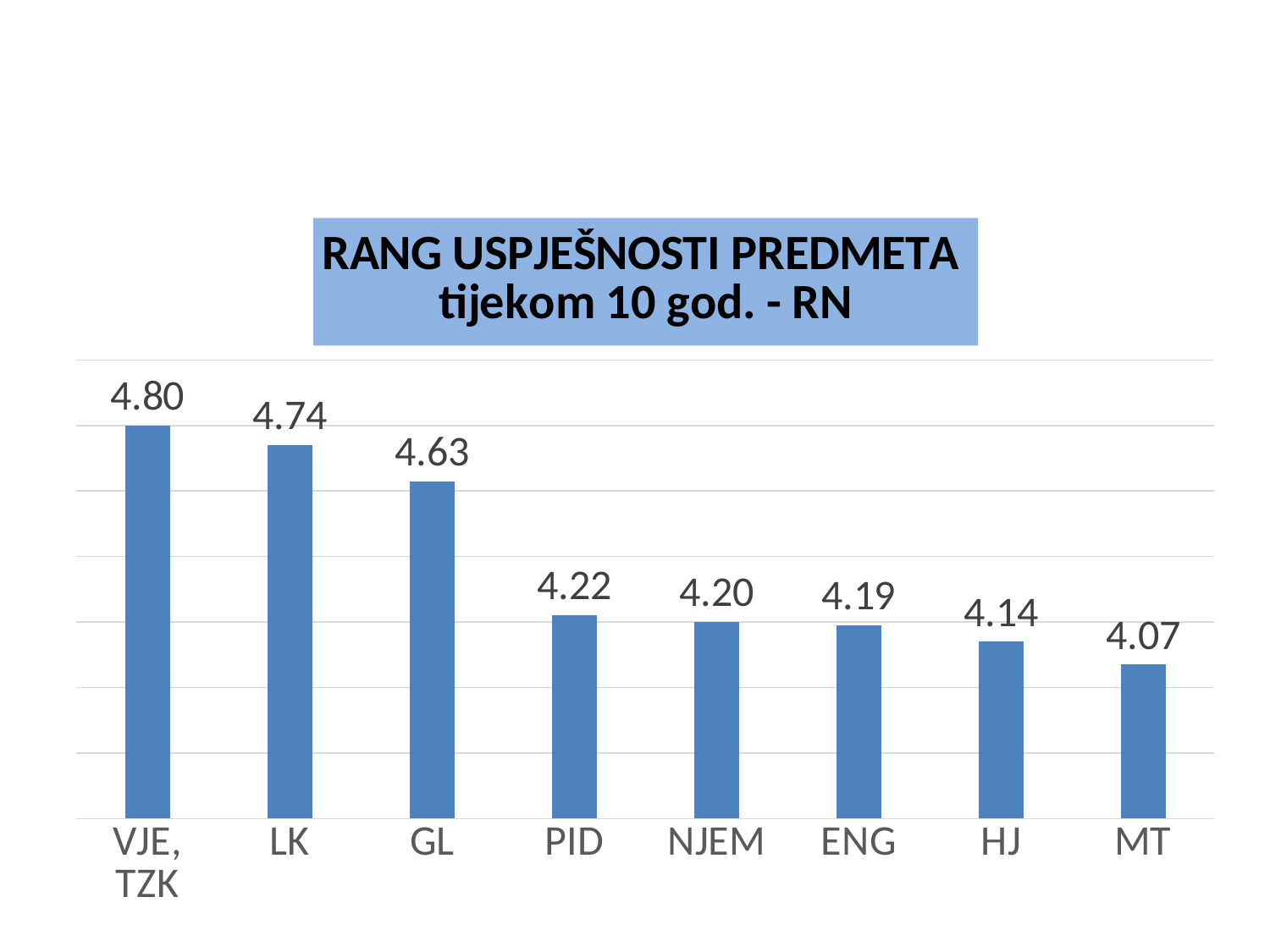
What is the title of the chart? RANG USPJEŠNOSTI PREDMETA tijekom 10 god. - RN Which category has the lowest value? MT What is the value for NJEM? 4.20 What kind of chart is this? bar chart How many categories are shown on the x axis? 8 Which category has the highest value? VJE, TZK What is the difference between the values for LK and GL? 0.11 Do the values rise or fall from left to right along the x axis? fall What is the difference between the values for VJE, TZK and MT? 0.73 Which is larger, the value for PID or the value for HJ? PID What is the value for GL? 4.63 What is the value for HJ? 4.14